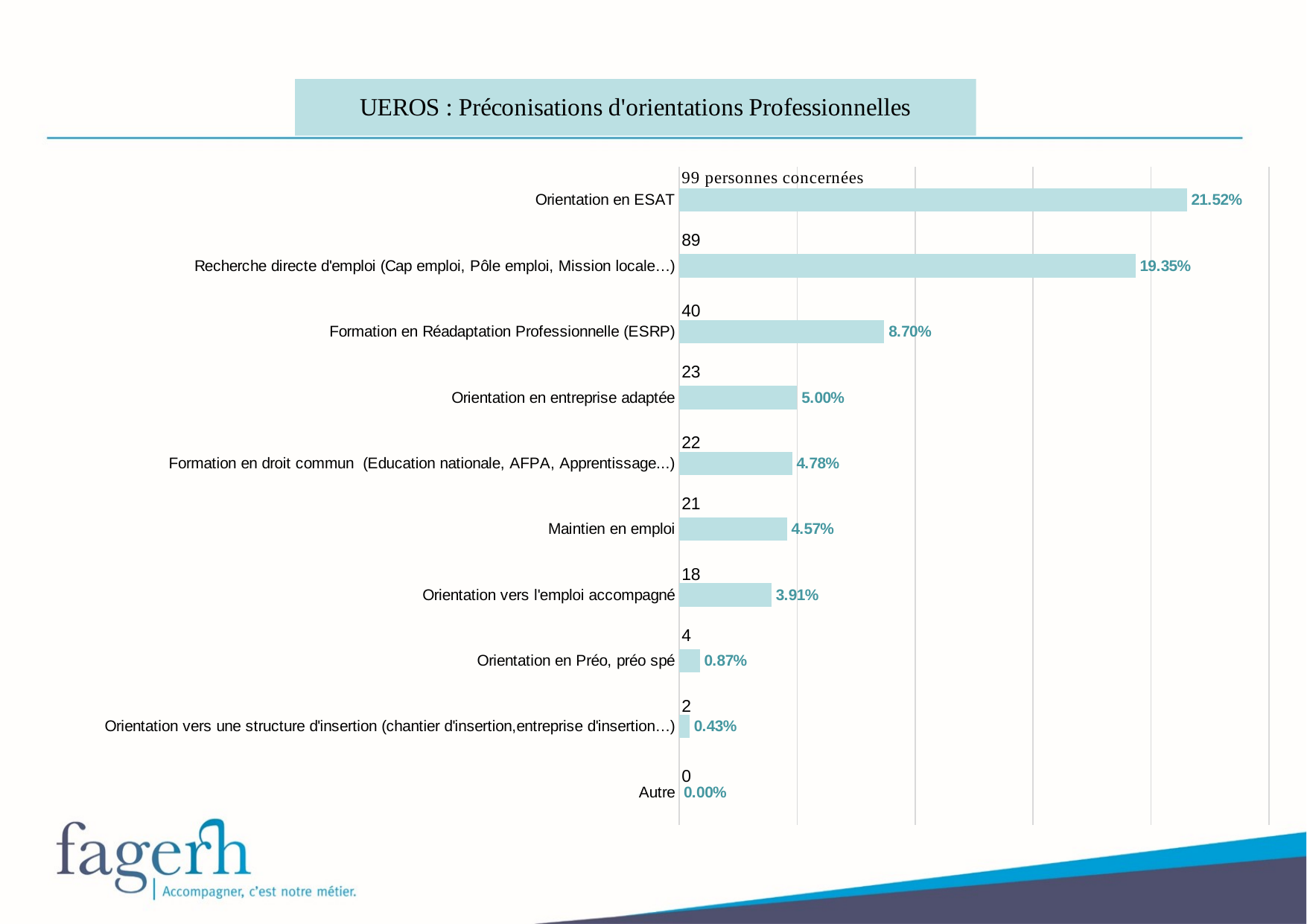
How many people are concerned by Orientation en Préo, préo spé? 4 How many people are concerned by Formation en Réadaptation Professionnelle (ESRP)? 40 What type of chart is shown on the slide? Bar chart How many categories are shown in the chart? 10 Which has a higher percentage, Orientation en entreprise adaptée or Orientation vers l'emploi accompagné? Orientation en entreprise adaptée What is the title of the slide? UEROS : Préconisations d'orientations Professionnelles What is the difference in number of people between Orientation en ESAT and Recherche directe d'emploi (Cap emploi, Pôle emploi, Mission locale…)? 10 What percentage is shown for Orientation vers une structure d'insertion (chantier d'insertion,entreprise d'insertion…)? 0.43% What percentage is shown for Maintien en emploi? 4.57% What percentage is shown for Orientation en ESAT? 21.52% Which category has the highest percentage? Orientation en ESAT Which category has the lowest percentage? Autre